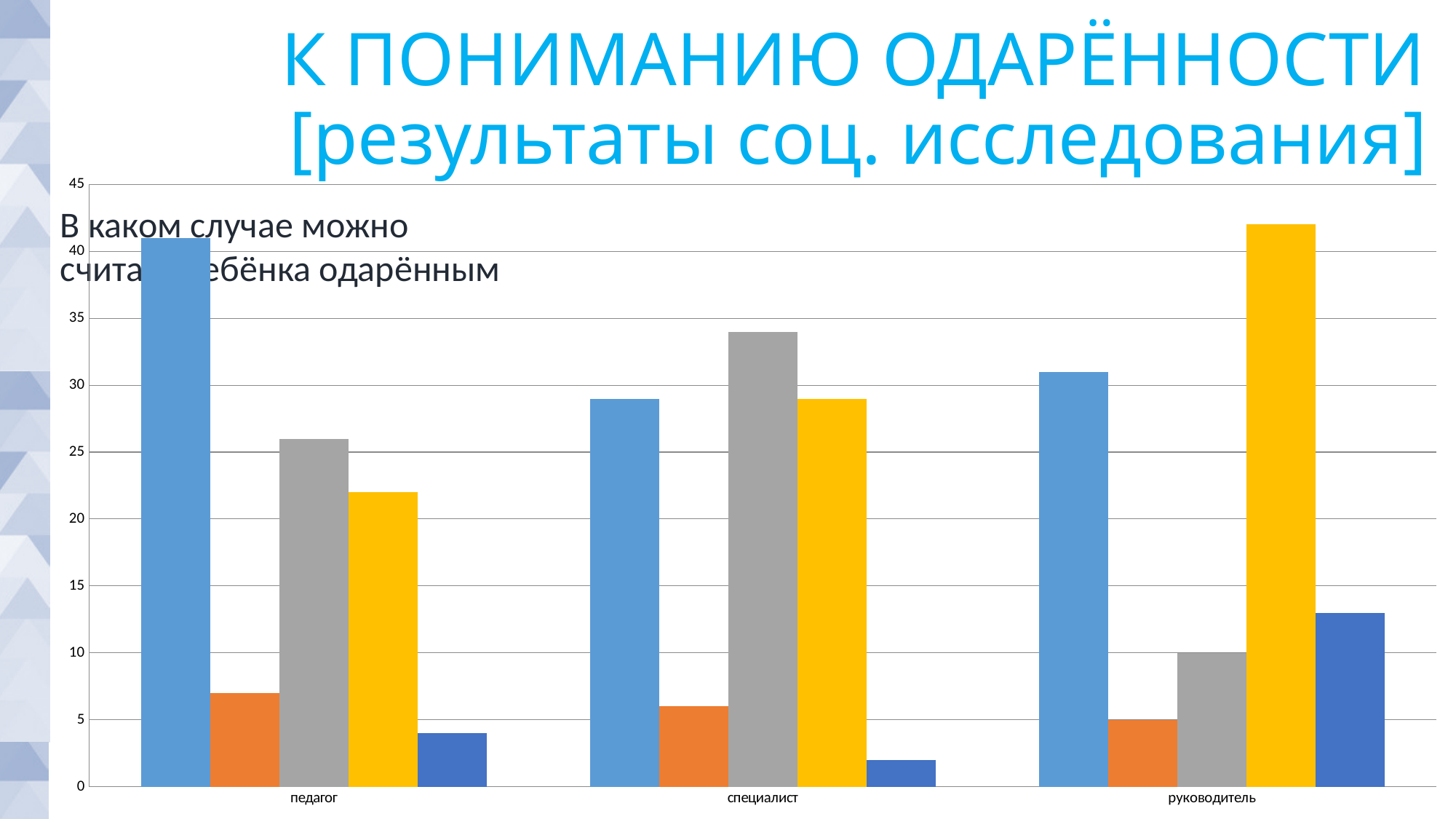
Which category has the tallest yellow bar? руководитель Is the gray bar for специалист greater or less than 30? greater What kind of chart is shown on the slide? bar chart Is the light blue bar for педагог greater or less than 40? greater How many bars are plotted for each category in the chart? 5 Which category has the tallest gray bar? специалист Is the yellow bar for педагог greater or less than 20? greater Which bar is the lowest in the специалист category? the dark blue bar Which is larger: the gray bar for педагог or the gray bar for руководитель? педагог How many categories are shown on the x axis of the chart? 3